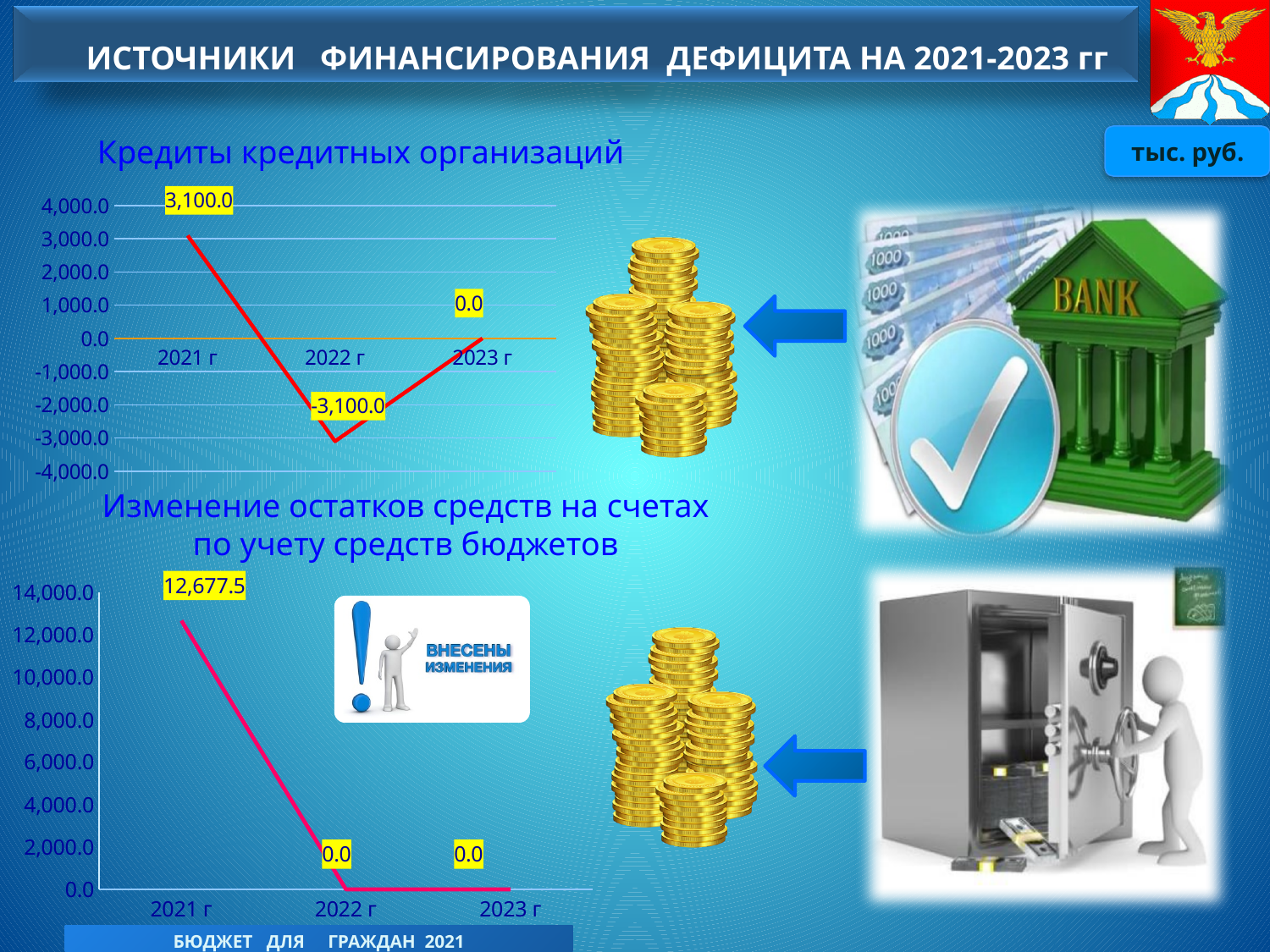
In the chart 'Изменение остатков средств на счетах по учету средств бюджетов', how many years are plotted? 3 In the chart 'Кредиты кредитных организаций', what is the value for 2023 г? 0.0 What kind of chart is 'Кредиты кредитных организаций'? Line chart In the chart 'Кредиты кредитных организаций', which is larger: the value for 2021 г or the value for 2023 г? 2021 г In the chart 'Изменение остатков средств на счетах по учету средств бюджетов', what is the value for 2022 г? 0.0 In the chart 'Изменение остатков средств на счетах по учету средств бюджетов', which year has the highest value? 2021 г In the chart 'Кредиты кредитных организаций', what is the value for 2021 г? 3,100.0 In the chart 'Кредиты кредитных организаций', what is the value for 2022 г? -3,100.0 In the chart 'Кредиты кредитных организаций', what is the difference between the values for 2021 г and 2022 г? 6,200.0 In the chart 'Кредиты кредитных организаций', which year has the lowest value? 2022 г In the chart 'Изменение остатков средств на счетах по учету средств бюджетов', what is the value for 2021 г? 12,677.5 In the chart 'Изменение остатков средств на счетах по учету средств бюджетов', do the values rise or fall from 2021 г to 2022 г? Fall